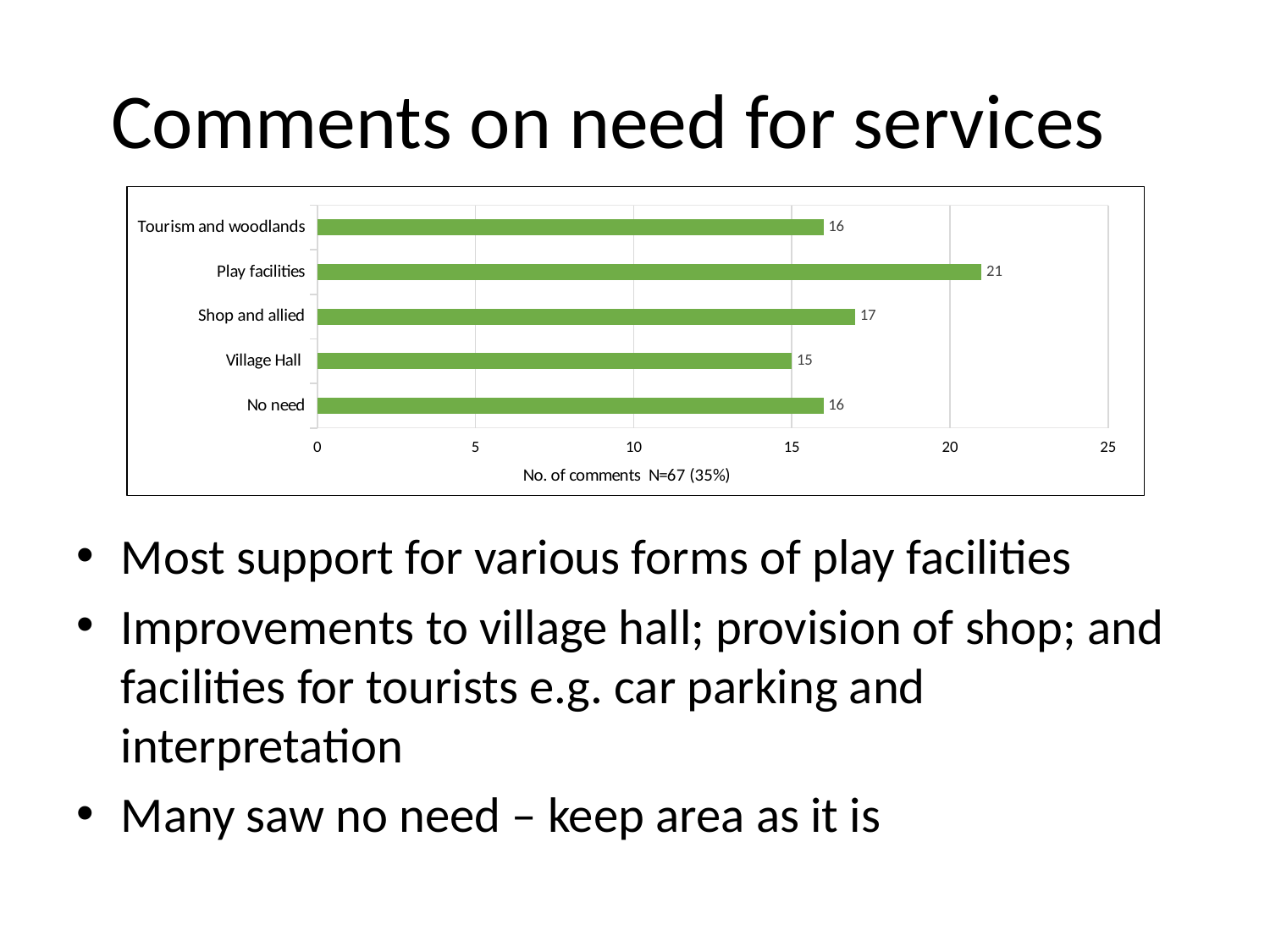
How many categories are shown in the chart? 5 What kind of chart is shown on the slide? bar chart What is the difference between the values for Play facilities and Village Hall? 6 What is the value for Tourism and woodlands? 16 Is the value for Play facilities greater or less than 20? greater What is the value for Shop and allied? 17 How many comments are recorded for Play facilities? 21 What is the value for Village Hall? 15 What is the x-axis label of the chart? No. of comments N=67 (35%) Which category has the lowest number of comments? Village Hall Which has more comments, Shop and allied or No need? Shop and allied Which category has the highest number of comments? Play facilities